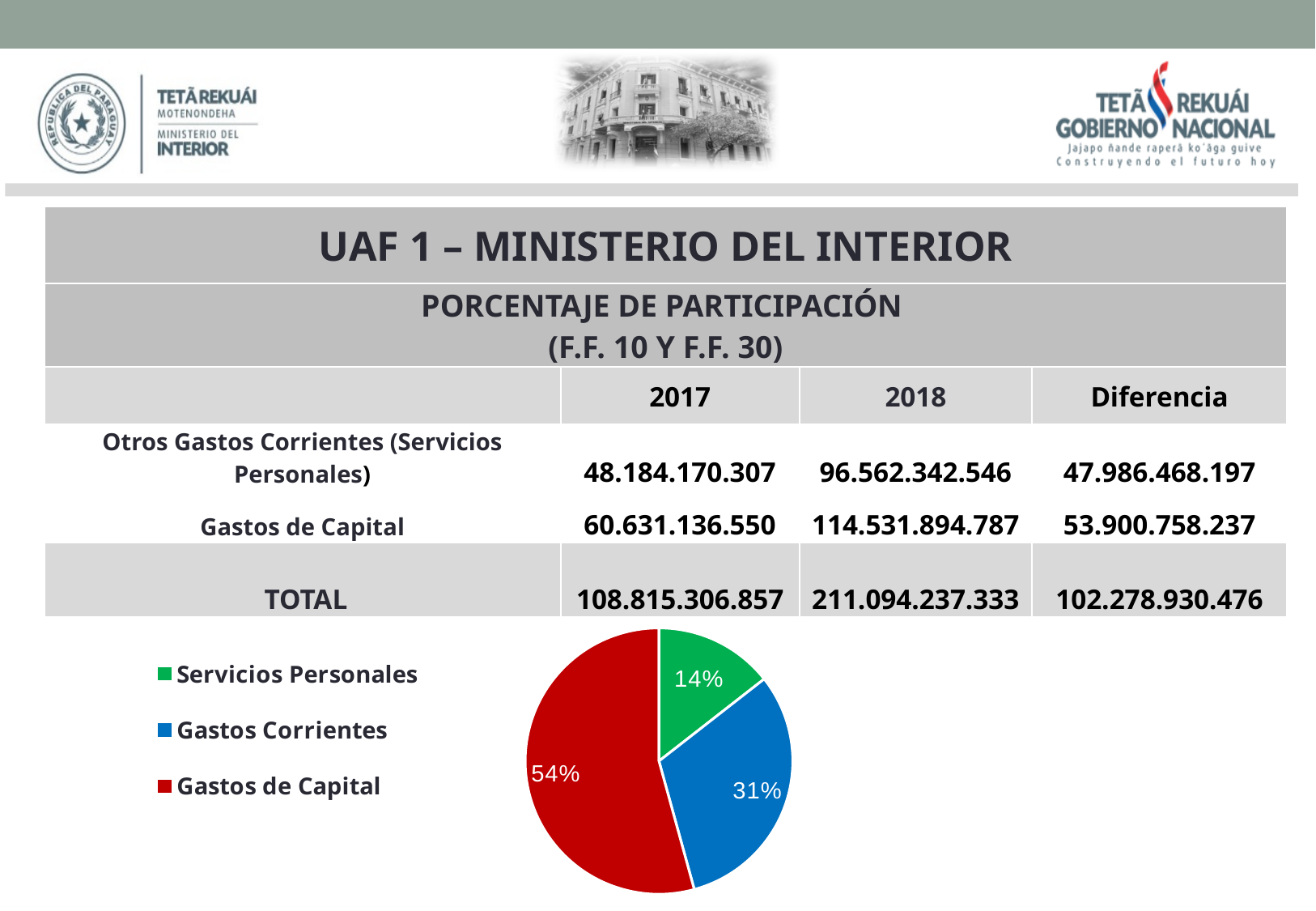
What share of the pie chart does Servicios Personales represent? 14% What colour is the Gastos de Capital slice in the pie chart? Red Which category has the largest slice in the pie chart? Gastos de Capital How many slices does the pie chart have? 3 Which category has the smallest slice in the pie chart? Servicios Personales By how many percentage points does the Gastos de Capital slice exceed the Gastos Corrientes slice? 23 By how many percentage points does the Gastos Corrientes slice exceed the Servicios Personales slice? 17 What type of chart is shown on the slide? Pie chart What share of the pie chart does Gastos de Capital represent? 54% What share of the pie chart does Gastos Corrientes represent? 31% Which slice is larger in the pie chart, Gastos Corrientes or Servicios Personales? Gastos Corrientes How many entries does the pie chart's legend list? 3